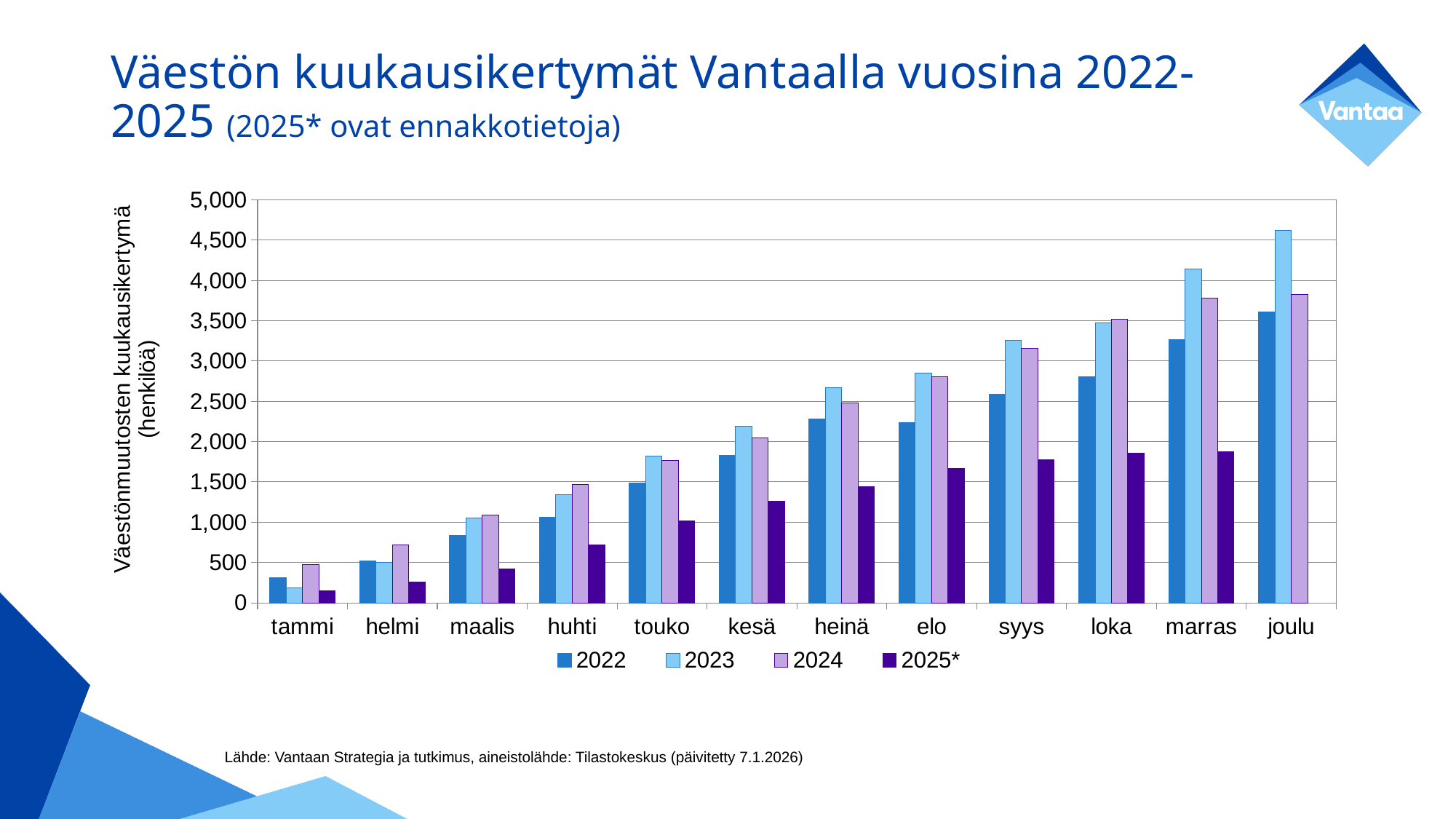
In joulu, which series has the larger value, 2023 or 2024? 2023 What kind of chart is shown on the slide? bar chart How many series does the legend list? 4 In tammi, which series has the larger value, 2022 or 2024? 2024 Do the values of the 2023 series rise or fall from tammi to joulu? rise Is the 2022 value for loka greater or less than 3,000? less Which month has the highest value for the 2023 series? joulu Which month has the lowest value for the 2025* series? tammi What are the entries listed in the legend? 2022, 2023, 2024, 2025* Is the 2023 value for joulu greater or less than 4,500? greater How many month categories are shown on the x axis? 12 Is the 2025* value for marras greater or less than 2,000? less